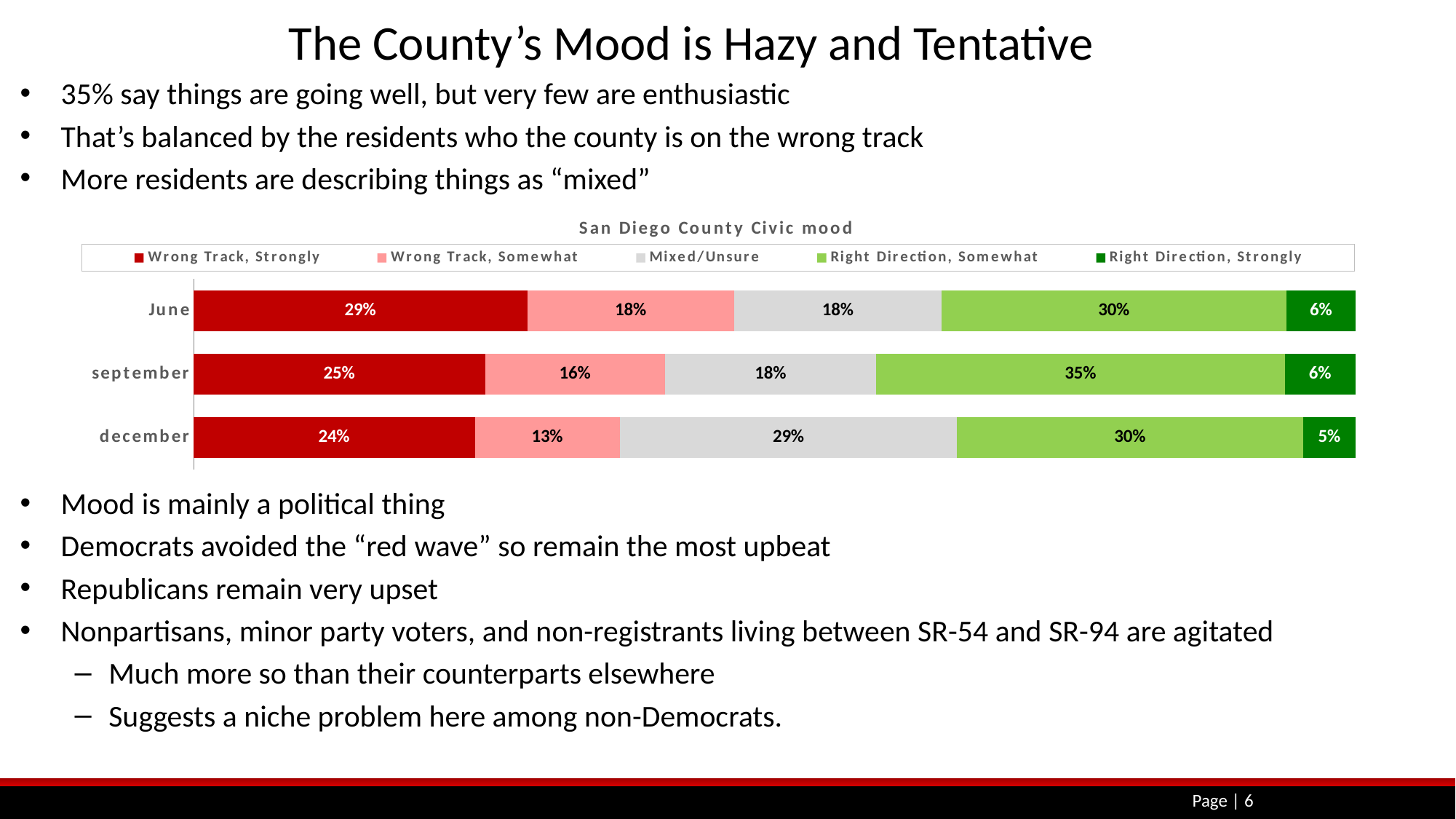
What is the title of the chart? San Diego County Civic mood Which period has the highest Wrong Track, Strongly value? June What is the Mixed/Unsure value for december? 29% What is the difference between the Mixed/Unsure values for december and June? 11% Which series is shown in dark green in the chart? Right Direction, Strongly How many series does the chart legend list? 5 What is the Wrong Track, Strongly value for June? 29% What type of chart is shown on the slide? Stacked bar chart Is the Right Direction, Somewhat value larger for september or for december? september How many time periods (bars) are shown in the chart? 3 What is the Right Direction, Somewhat value for september? 35% Which period has the lowest Wrong Track, Somewhat value? december